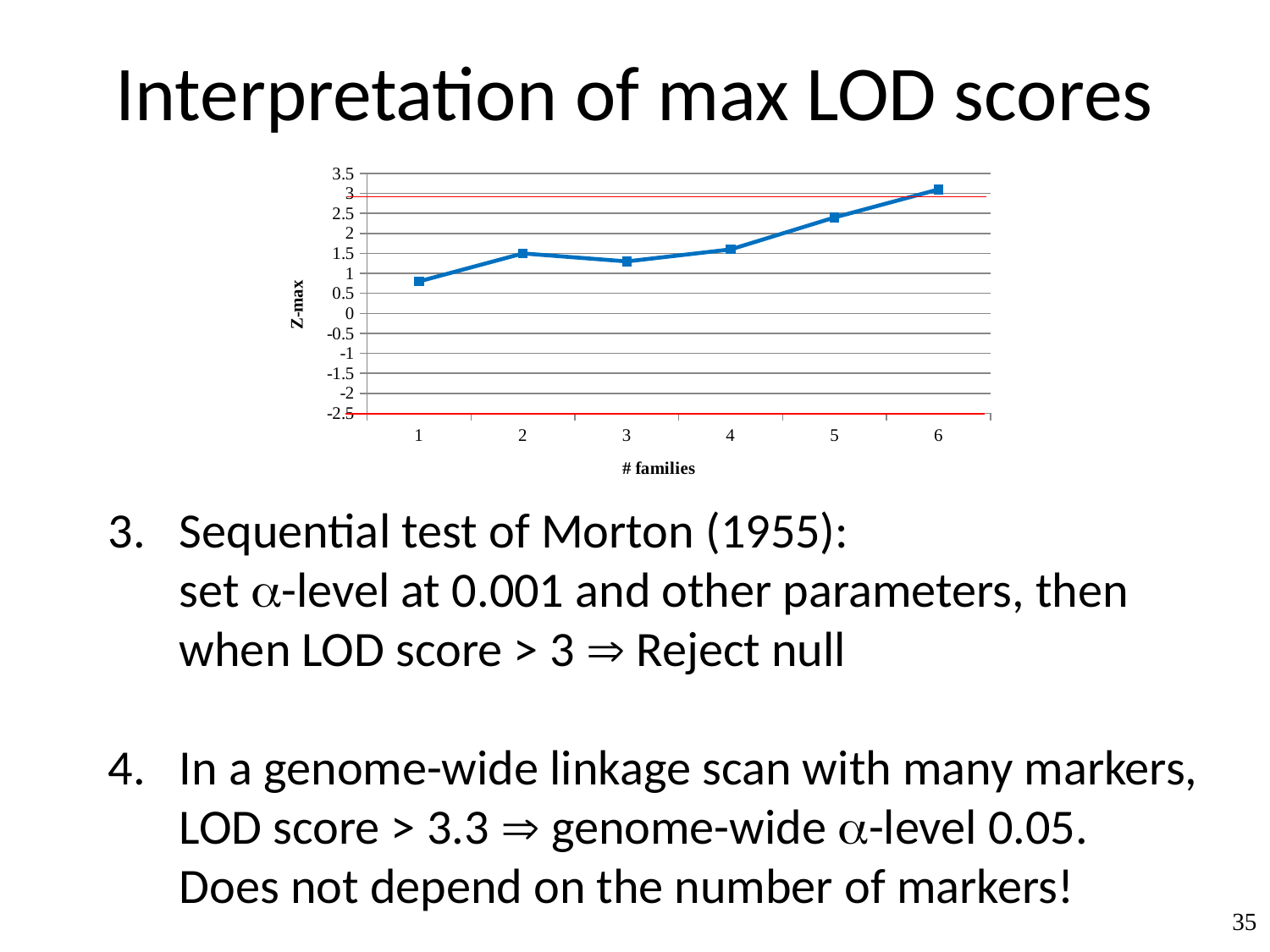
What kind of chart is shown on the slide? line chart Is the Z-max value for 3 families greater or less than 1.5? less Overall, does Z-max rise or fall as the number of families increases from 1 to 6? rise At which number of families is Z-max lowest? 1 At which number of families is Z-max highest? 6 Which has a larger Z-max value: 2 families or 3 families? 2 families Which has a larger Z-max value: 4 families or 5 families? 5 families Is the Z-max value for 6 families greater or less than 3? greater Is the Z-max value for 1 family greater or less than 1? less What is the label of the y axis? Z-max How many points (number of families) are plotted along the x axis? 6